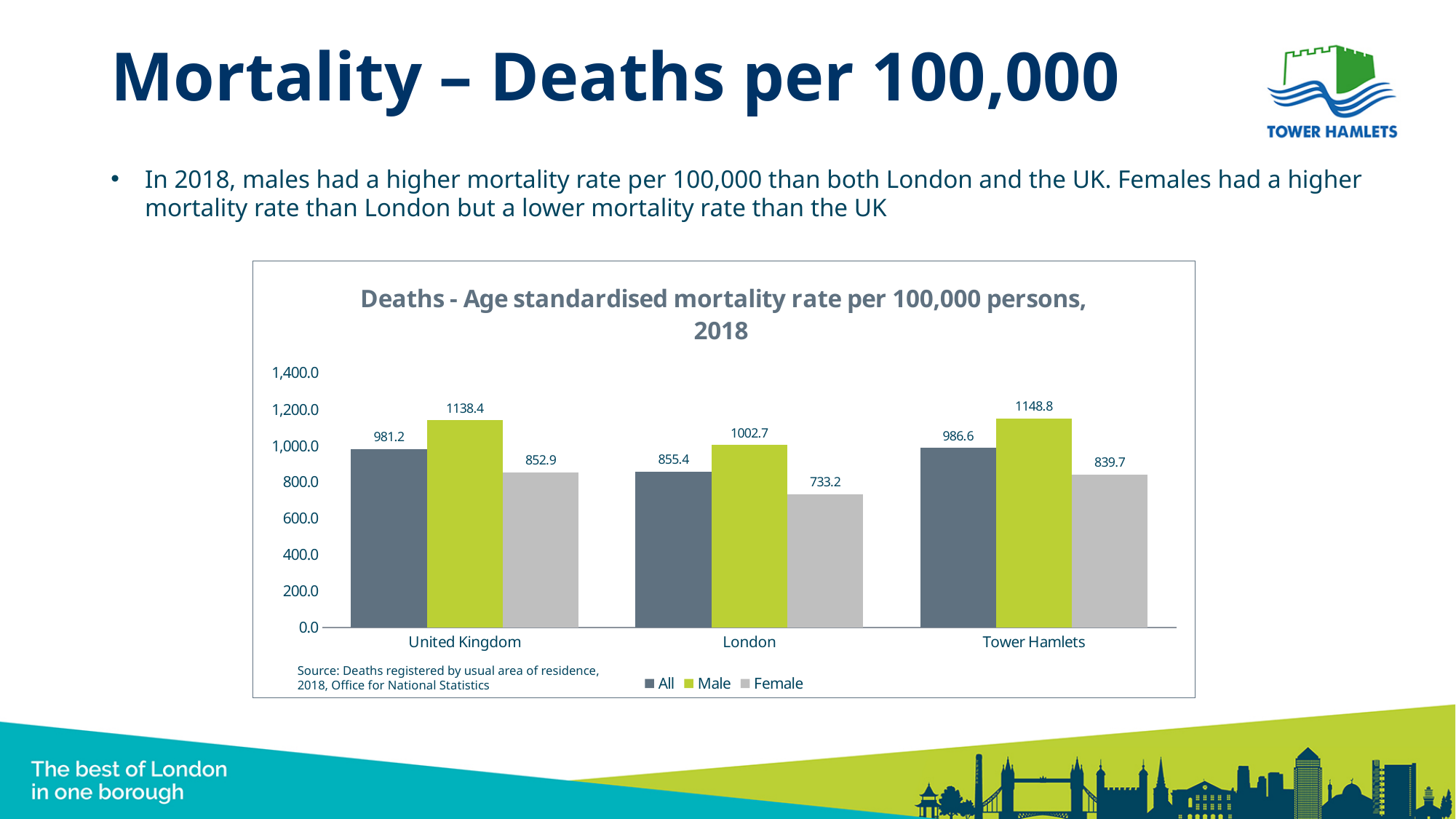
What is the All mortality rate for the United Kingdom? 981.2 What is the title of the chart? Deaths - Age standardised mortality rate per 100,000 persons, 2018 How many areas are shown on the x axis? 3 What is the Female mortality rate for London? 733.2 What is the difference between the Male and Female mortality rates for the United Kingdom? 285.5 What kind of chart is shown? bar chart Which area has the highest Male mortality rate? Tower Hamlets Is the All mortality rate for London greater or less than 1,000.0? less Which is larger, the Female mortality rate for the United Kingdom or for Tower Hamlets? United Kingdom What is the Male mortality rate for Tower Hamlets? 1148.8 How many series does the legend list? 3 Which area has the lowest Female mortality rate? London